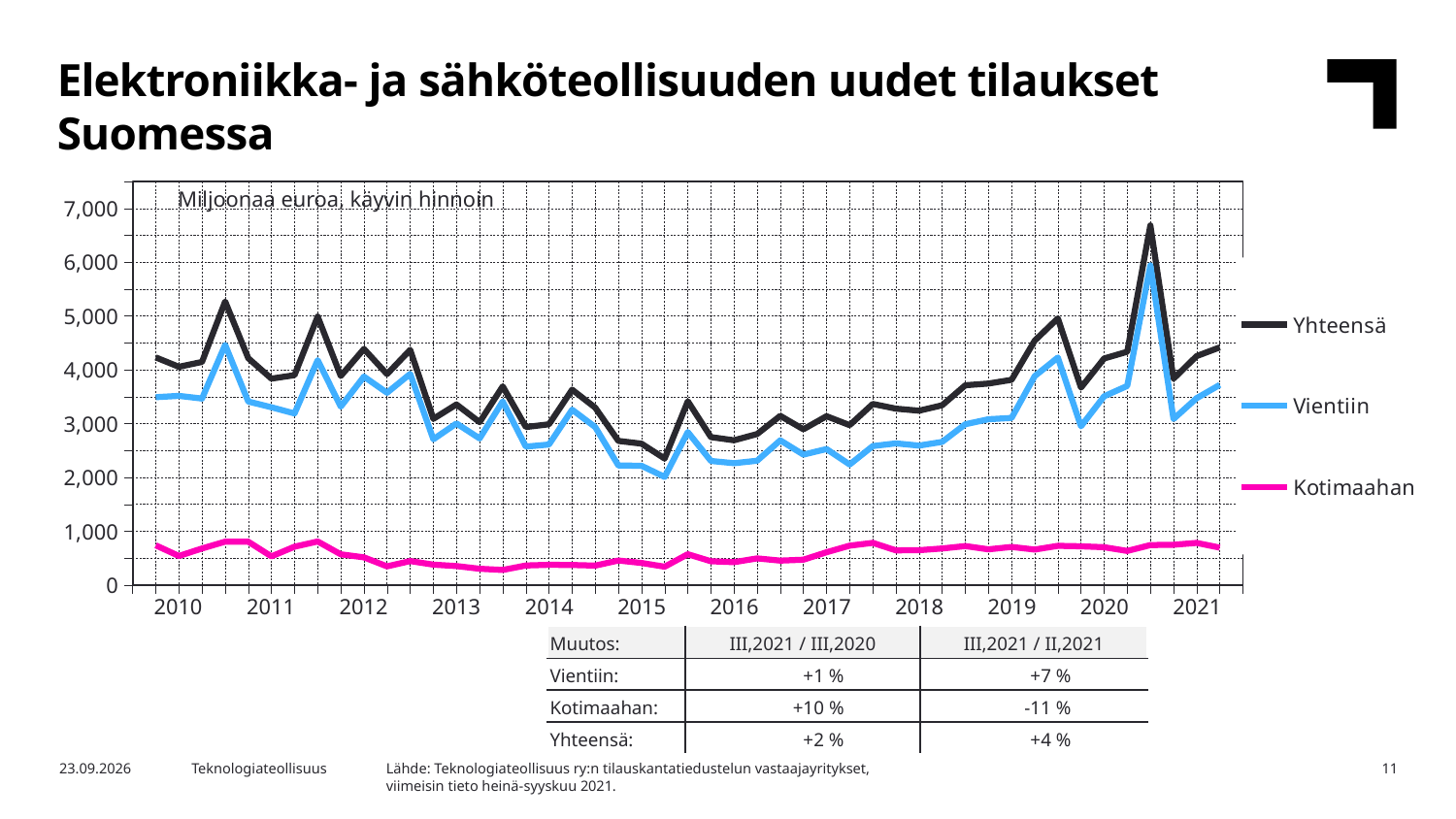
Is the peak value of Yhteensä in 2020 greater or less than 6,000? greater What are the three series named in the legend? Yhteensä, Vientiin, Kotimaahan Does the Yhteensä line generally rise or fall between 2012 and 2015? fall Which series has the lowest values across the whole period? Kotimaahan How many series does the legend list? 3 What unit label is printed inside the chart area? Miljoonaa euroa, käyvin hinnoin Is the value for Kotimaahan in 2015 greater or less than 1,000? less How many years are labelled on the x axis? 12 Is the peak value of Vientiin in 2020 greater or less than 5,000? greater Which is larger at the start of 2010, Yhteensä or Vientiin? Yhteensä What kind of chart is shown on the slide? line chart Which series reaches the highest value on the chart? Yhteensä